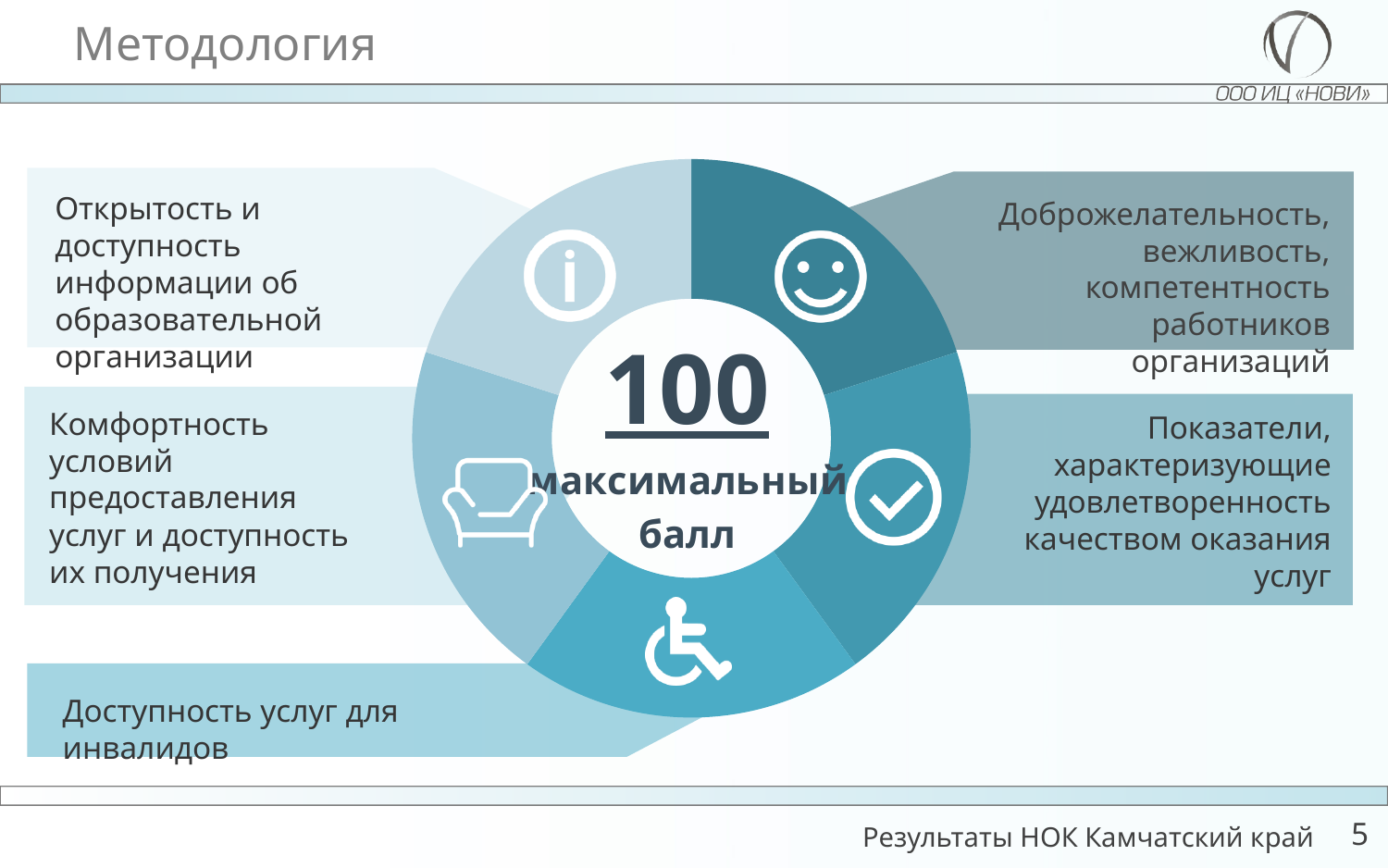
How many segments does the ring diagram on the slide have? 5 What number is shown in the centre of the ring diagram? 100 What does the text in the centre of the ring diagram say the number 100 represents? максимальный балл Which criterion is labelled next to the wheelchair icon at the bottom of the ring diagram? Доступность услуг для инвалидов What is the title of the slide containing the ring diagram? Методология